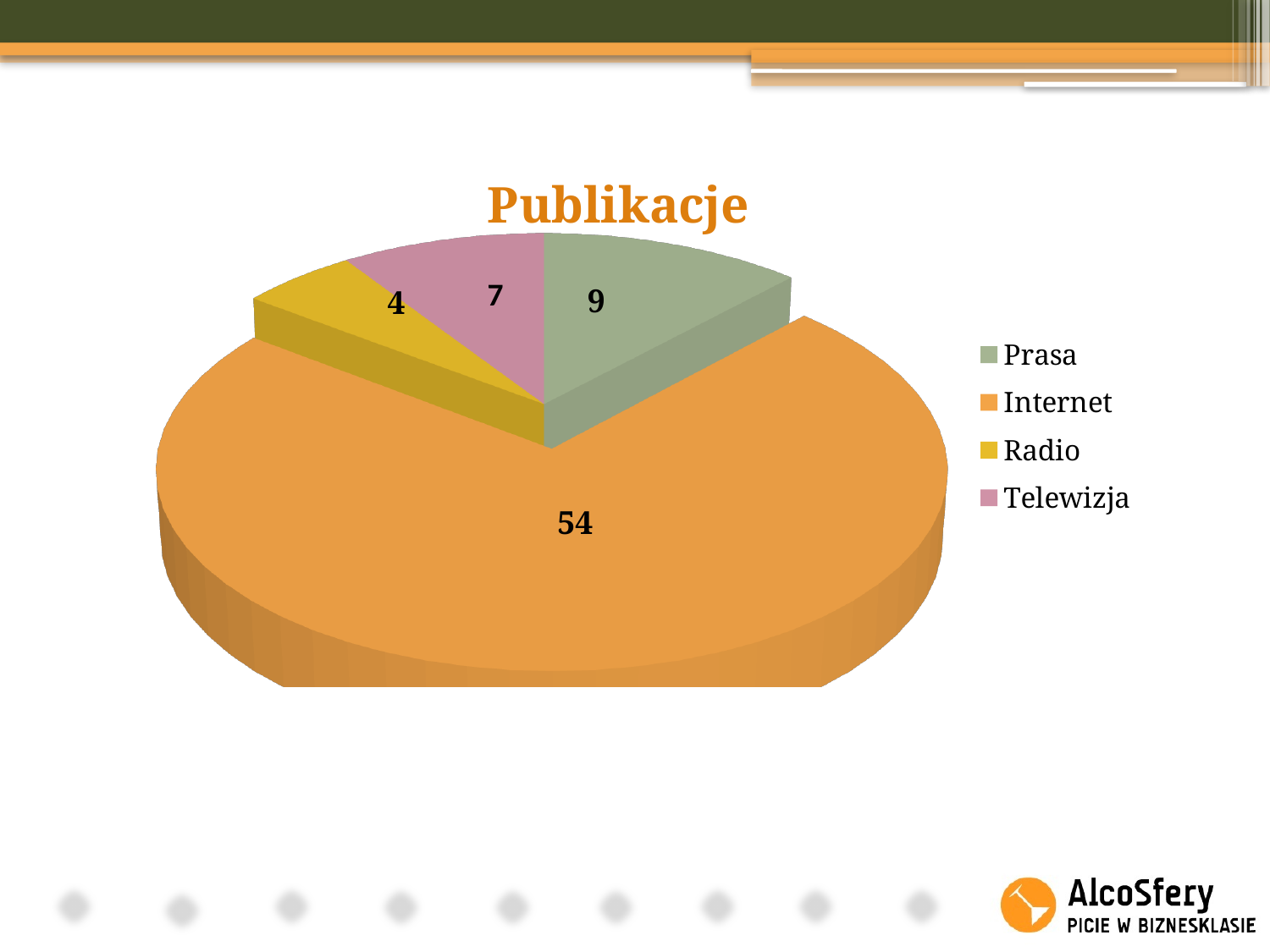
What is the value for Radio? 4 What is the value for Prasa? 9 What is the value for Telewizja? 7 What is the difference between the values for Internet and Prasa? 45 Which category has the largest slice? Internet What is the total of all the slice values in the chart? 74 What is the title of the chart? Publikacje What is the value for Internet? 54 Which category has the smallest slice? Radio Which is larger, the value for Prasa or the value for Telewizja? Prasa What type of chart is shown on the slide? pie chart How many categories does the pie chart have? 4